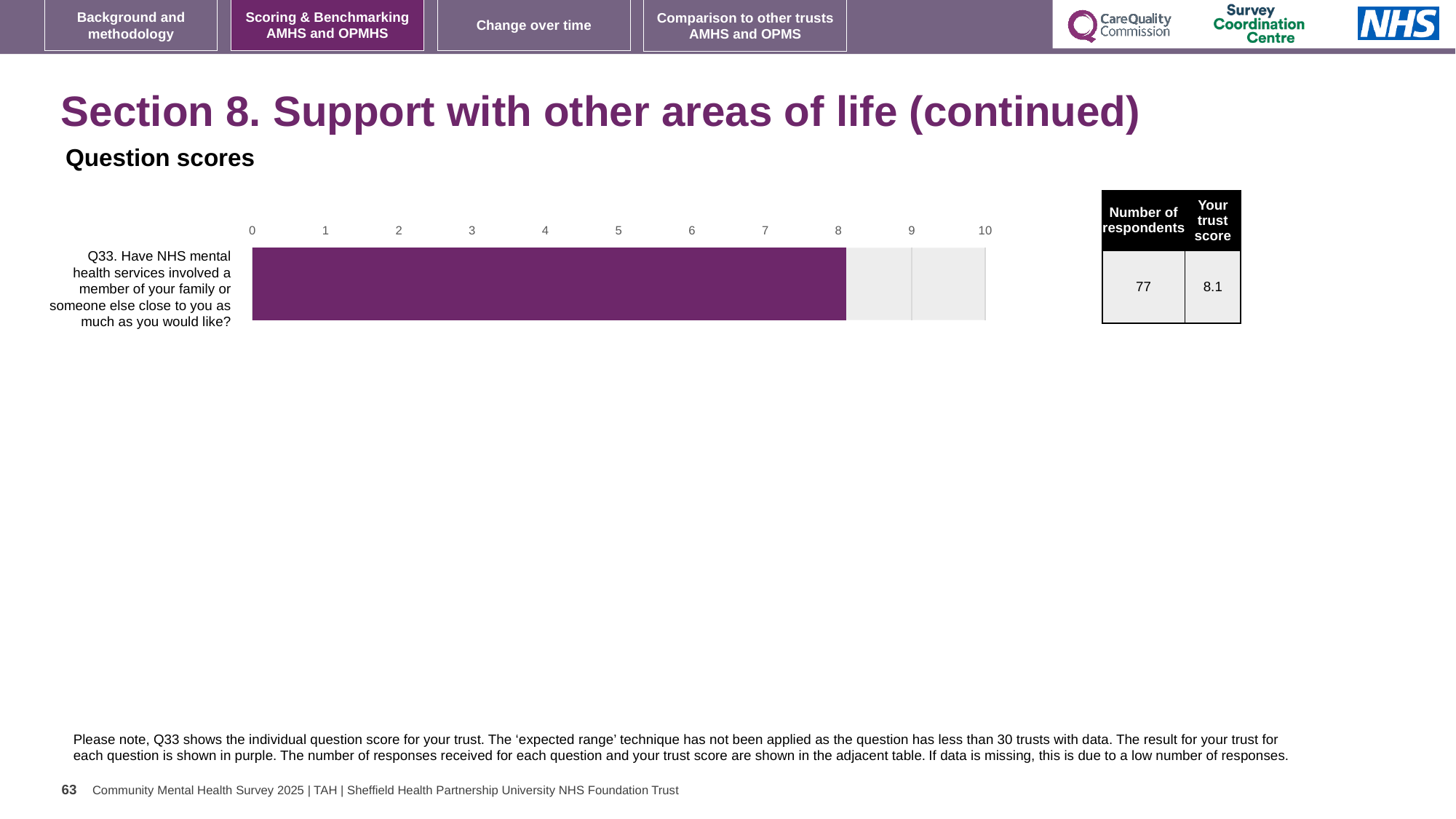
Is the value for Q33 greater or less than 7? greater What is the trust score for Q33 shown in the table next to the chart? 8.1 What colour is the bar showing the trust's result for Q33? Purple What kind of chart is used to show the Q33 question score? Bar chart Which question number is plotted on the chart? Q33 What is the maximum value shown on the chart's horizontal axis? 10 Is the value for Q33 greater or less than 9? less How many questions (bars) are plotted on the chart? 1 How many respondents answered Q33 according to the table next to the chart? 77